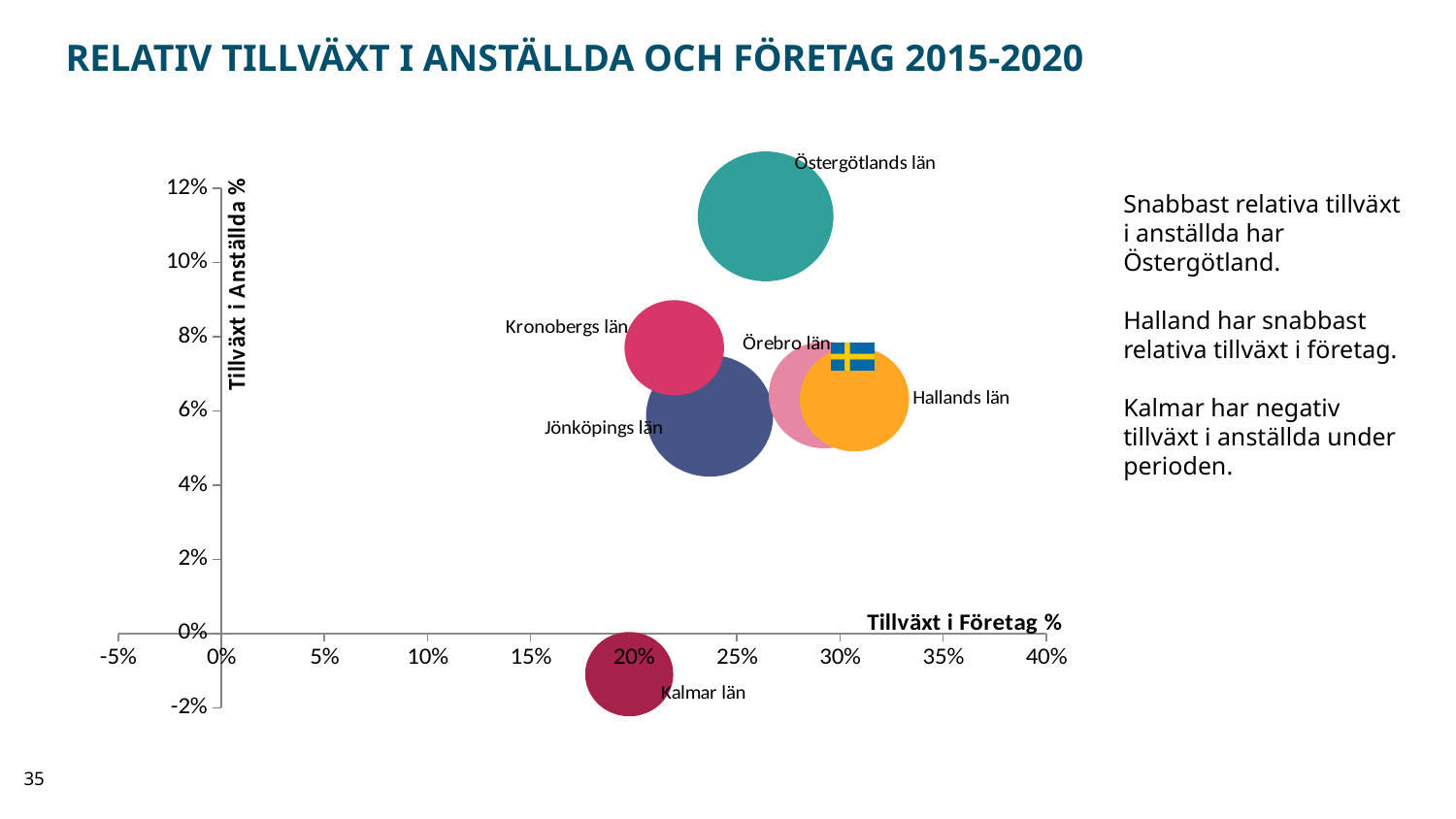
What kind of chart is shown on the slide? Bubble chart Is the employee growth (Tillväxt i Anställda %) for Jönköpings län greater or less than 8%? less Which län has the highest relative growth in companies (Tillväxt i Företag %)? Hallands län What is the title of the vertical axis? Tillväxt i Anställda % Which has higher employee growth (Tillväxt i Anställda %), Kronobergs län or Kalmar län? Kronobergs län Is the company growth (Tillväxt i Företag %) for Hallands län greater or less than 25%? greater Is the employee growth (Tillväxt i Anställda %) for Östergötlands län greater or less than 10%? greater Which län has the highest relative growth in employees (Tillväxt i Anställda %)? Östergötlands län How many län are labeled on the chart? 6 Which has higher company growth (Tillväxt i Företag %), Hallands län or Kronobergs län? Hallands län Which län has the lowest relative growth in employees (Tillväxt i Anställda %)? Kalmar län